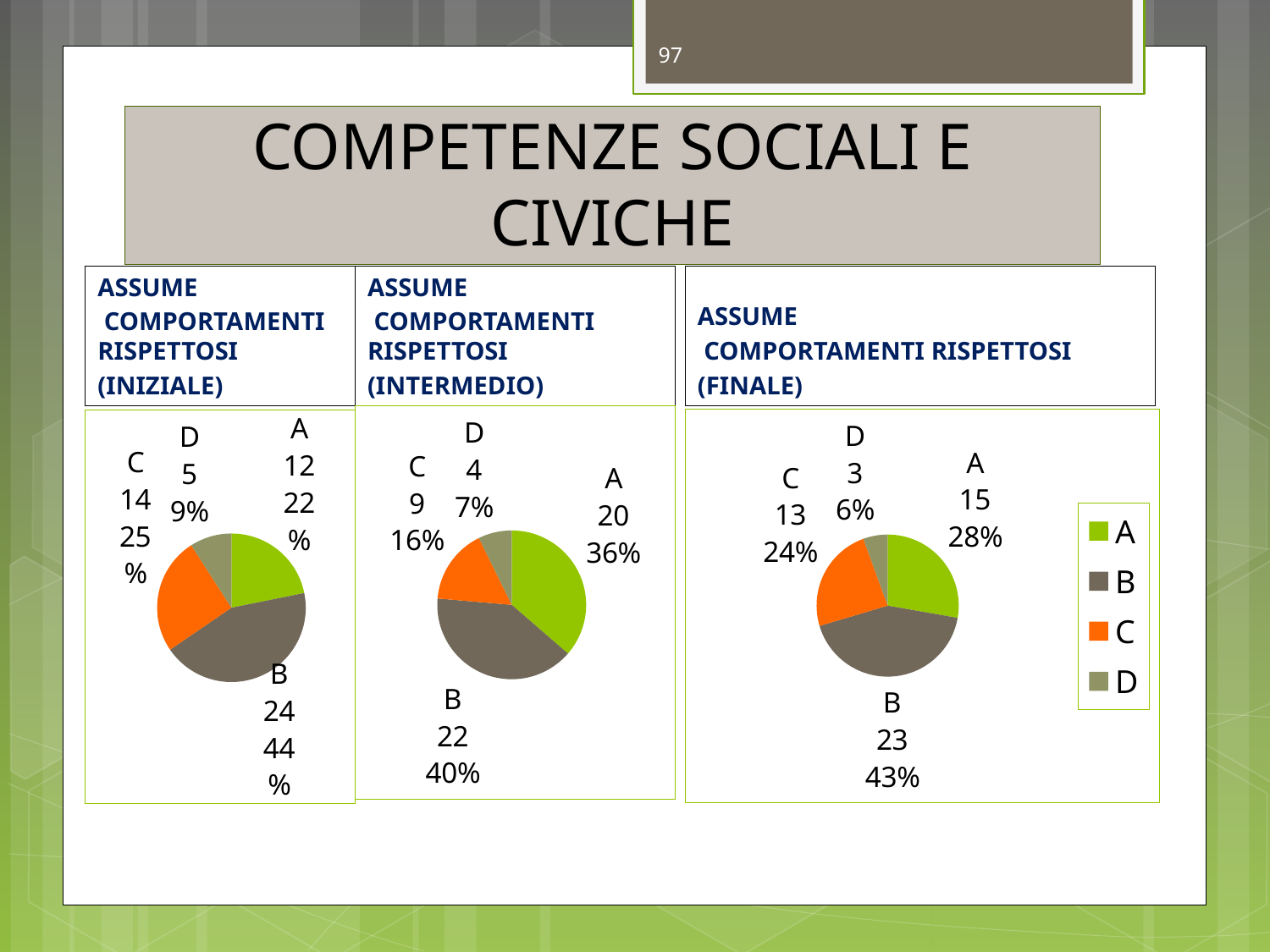
In the FINALE pie chart, which category has the largest slice? B How many entries does the legend next to the FINALE pie chart list? 4 What type of chart is used for the FINALE data? Pie chart In the INIZIALE pie chart, what is the difference in count between category B and category A? 12 In the INTERMEDIO pie chart, what percentage is shown for category A? 36% In the FINALE pie chart, which is larger, the slice for A or the slice for C? A How many slices does the INTERMEDIO pie chart have? 4 In the FINALE pie chart, what share of the pie does category C represent? 24% In the INTERMEDIO pie chart, which category has the smallest slice? D In the INIZIALE pie chart, what count is shown for category C? 14 In the INIZIALE pie chart, what percentage is shown for category B? 44% In the FINALE pie chart, what count is shown for category D? 3